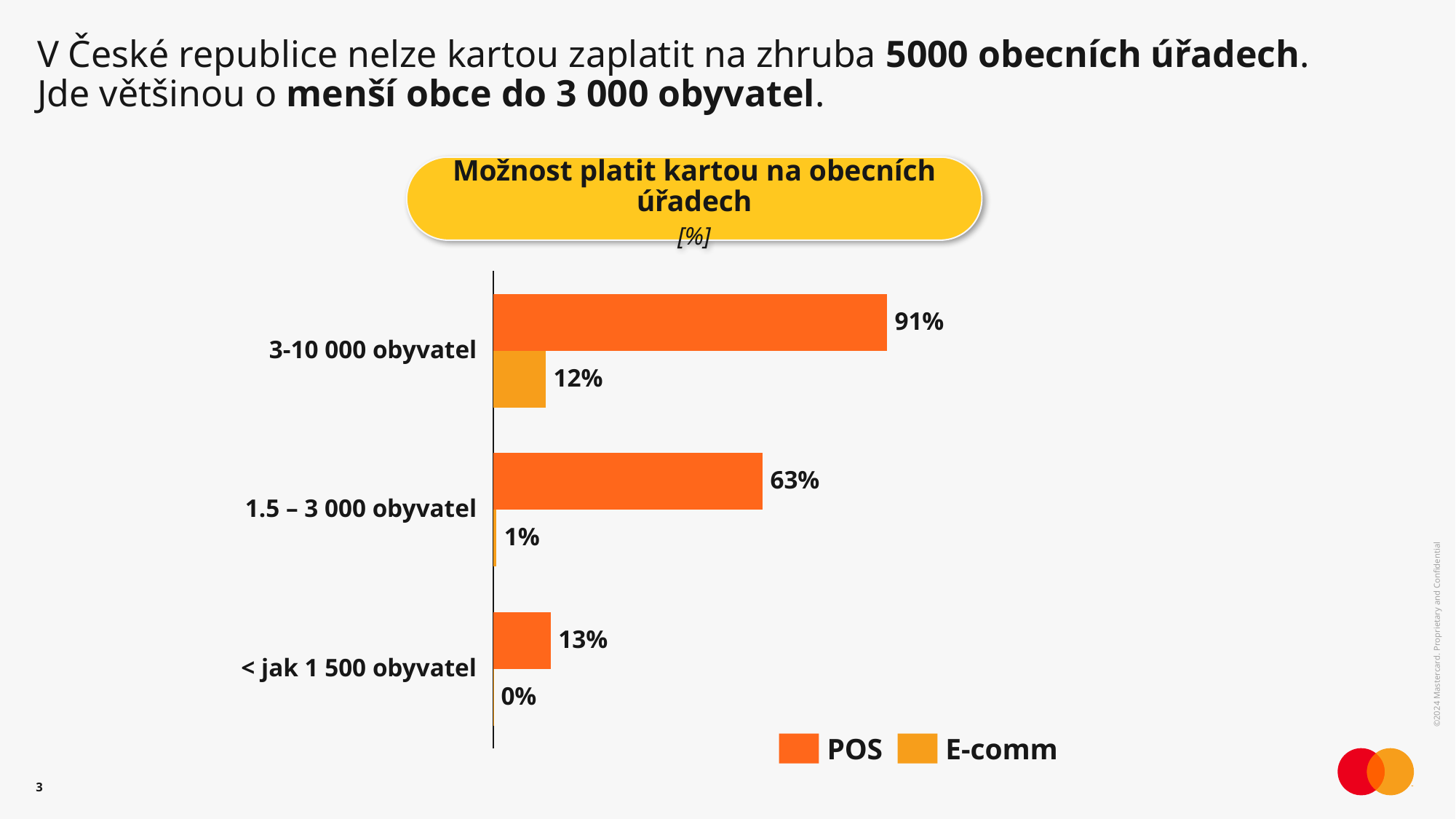
What kind of chart is shown on the slide? Bar chart What is the title of the chart? Možnost platit kartou na obecních úřadech How many categories are shown on the chart? 3 What is the E-comm value for 3-10 000 obyvatel? 12% What is the E-comm value for < jak 1 500 obyvatel? 0% What is the POS value for 1.5 – 3 000 obyvatel? 63% Which category has the lowest E-comm value? < jak 1 500 obyvatel What is the POS value for 3-10 000 obyvatel? 91% What is the difference between the POS values for 3-10 000 obyvatel and 1.5 – 3 000 obyvatel? 28% How many series does the legend list? 2 Which is larger: the POS value for < jak 1 500 obyvatel or the E-comm value for 3-10 000 obyvatel? POS value for < jak 1 500 obyvatel Which category has the highest POS value? 3-10 000 obyvatel